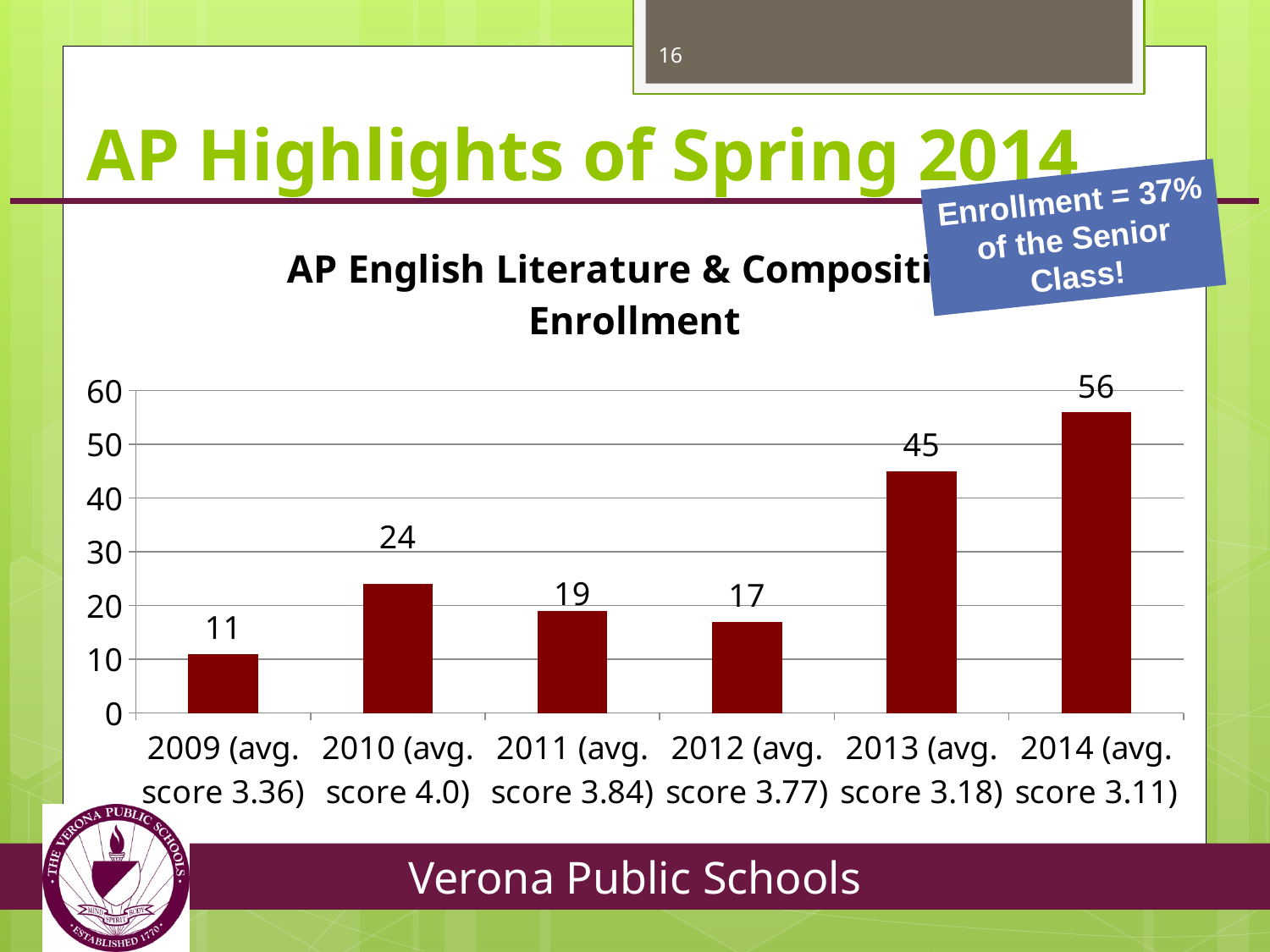
Which year had the highest enrollment? 2014 Which year had the lowest enrollment? 2009 What was the AP English Literature & Composition enrollment in 2014? 56 How many years are shown on the chart? 6 What is the difference in enrollment between 2014 and 2013? 11 Which year had higher enrollment, 2010 or 2012? 2010 What kind of chart is shown on the slide? Bar chart What was the enrollment in 2012? 17 Is the enrollment for 2013 greater or less than 40? greater What is the difference in enrollment between 2010 and 2011? 5 What average score is listed for 2010 on the x-axis label? 4.0 What was the enrollment in 2009? 11